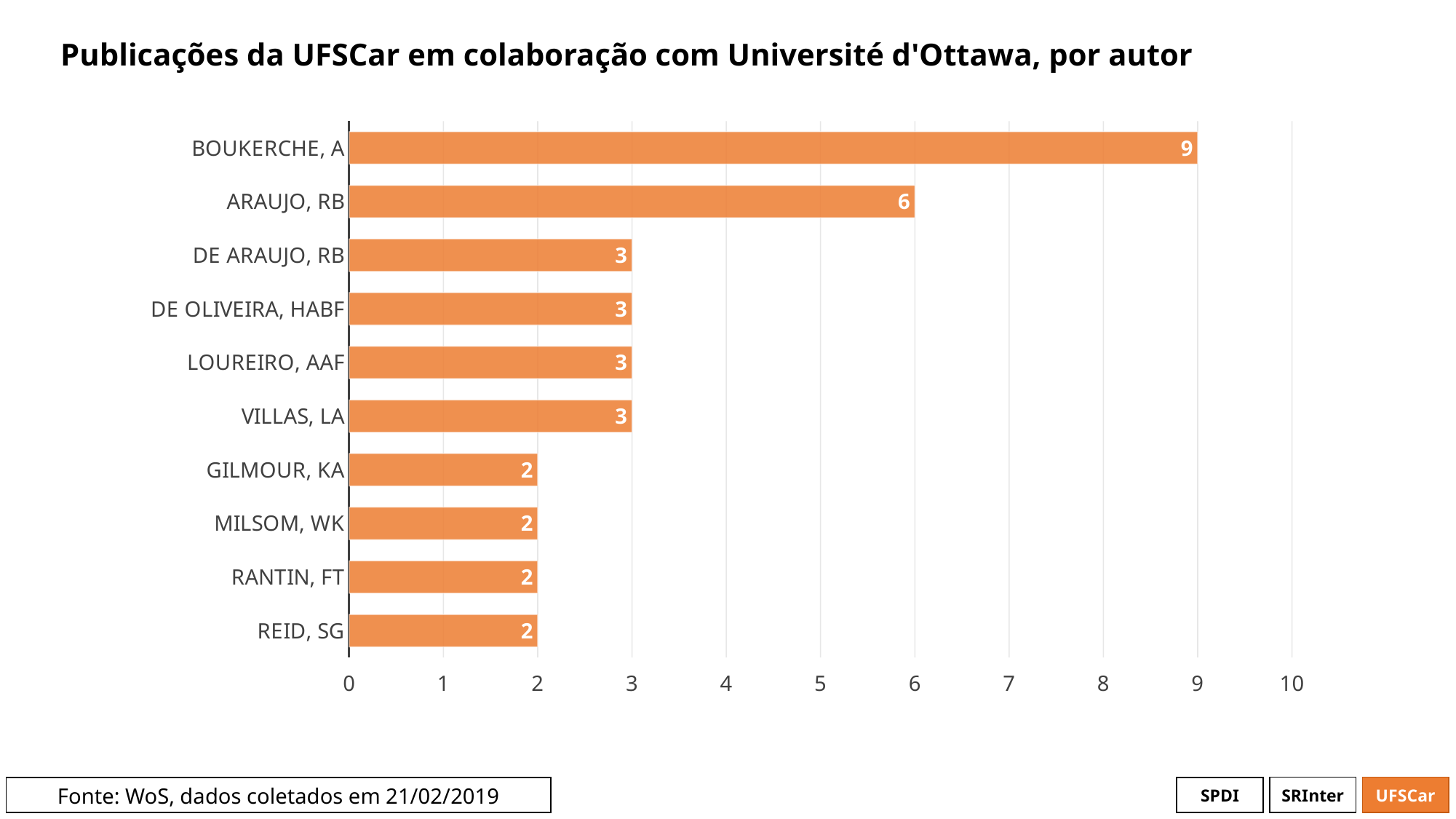
What is the difference between the values for DE ARAUJO, RB and GILMOUR, KA? 1 Which is larger, the value for ARAUJO, RB or the value for VILLAS, LA? ARAUJO, RB How many publications does BOUKERCHE, A have? 9 Is the value for BOUKERCHE, A greater or less than 8? greater What is the value for LOUREIRO, AAF? 3 What is the value for ARAUJO, RB? 6 What is the difference between the values for BOUKERCHE, A and ARAUJO, RB? 3 What is the value for REID, SG? 2 What is the title of the chart? Publicações da UFSCar em colaboração com Université d'Ottawa, por autor How many authors are shown in the chart? 10 What kind of chart is shown on the slide? bar chart Which author has the highest number of publications? BOUKERCHE, A